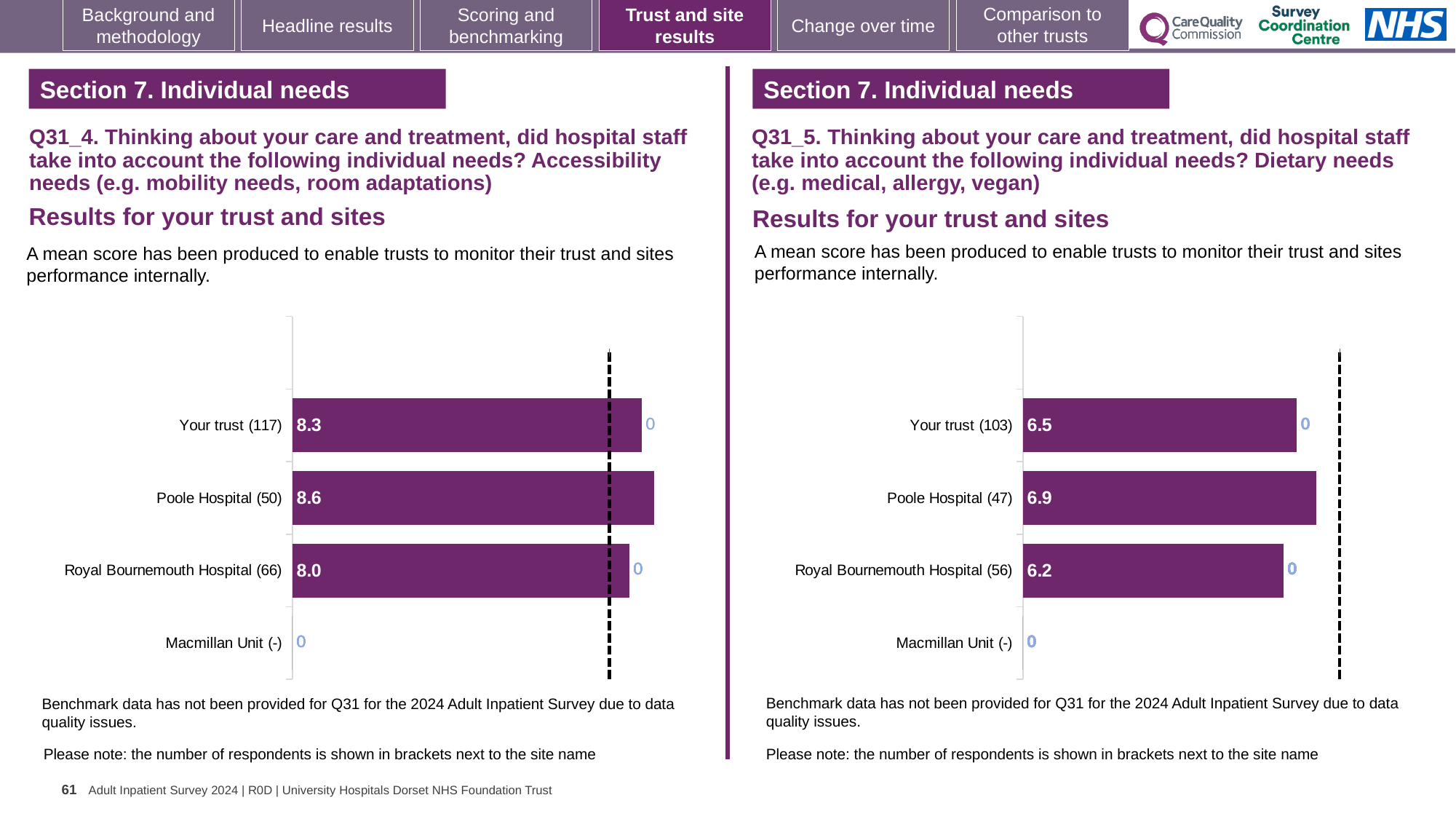
In the left chart (Q31_4, accessibility needs), what is the mean score for Your trust (117)? 8.3 In the right chart (Q31_5, dietary needs), what is the difference between the mean scores of Poole Hospital and Your trust? 0.4 In the left chart (Q31_4, accessibility needs), what is the mean score for Poole Hospital (50)? 8.6 In the right chart (Q31_5, dietary needs), which site or trust has the highest mean score? Poole Hospital (47) In the right chart (Q31_5, dietary needs), what is the mean score for Poole Hospital (47)? 6.9 In the left chart (Q31_4, accessibility needs), what is the mean score for Royal Bournemouth Hospital (66)? 8.0 In the right chart (Q31_5, dietary needs), what is the mean score for Your trust (103)? 6.5 In the right chart (Q31_5, dietary needs), what is the mean score for Royal Bournemouth Hospital (56)? 6.2 What type of chart is used on the left side of the slide (Q31_4)? Bar chart In the left chart (Q31_4, accessibility needs), which site or trust has the highest mean score? Poole Hospital (50) In the right chart (Q31_5, dietary needs), which has the larger mean score: Your trust or Royal Bournemouth Hospital? Your trust In the left chart (Q31_4, accessibility needs), what is the difference between the mean scores of Poole Hospital and Royal Bournemouth Hospital? 0.6